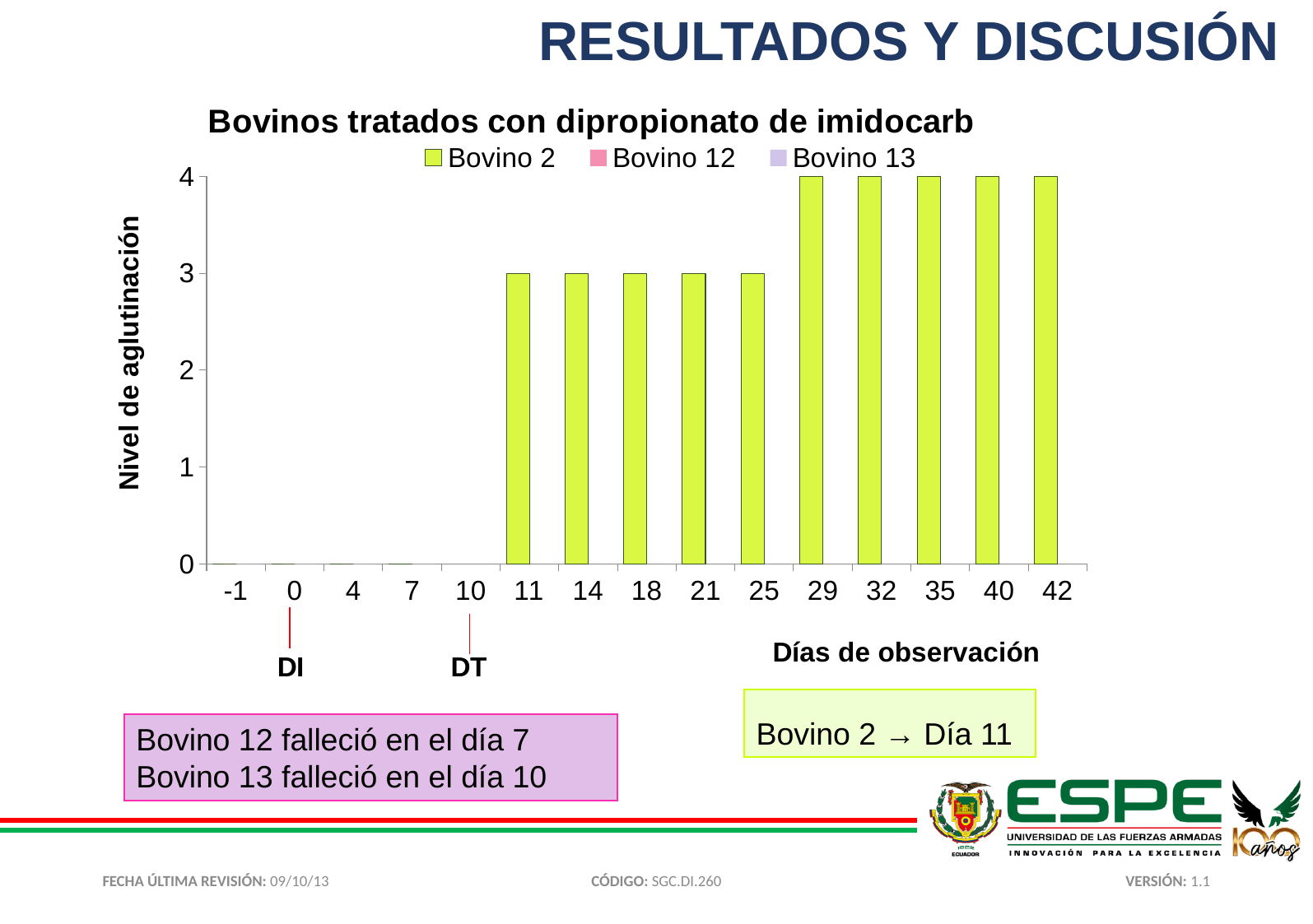
Is the value for Bovino 2 on day 32 greater or less than 3? greater What is the difference between the Bovino 2 value on day 29 and on day 25? 1 What is the title of the chart? Bovinos tratados con dipropionato de imidocarb Which is larger for Bovino 2: the value on day 14 or the value on day 35? day 35 What is the label of the y axis of the chart? Nivel de aglutinación What type of chart is shown on the slide? bar chart What is the agglutination level for Bovino 2 on day 42? 4 What is the agglutination level for Bovino 2 on day 11? 3 How many series does the chart legend list? 3 How many day categories are shown on the x axis of the chart? 15 What is the agglutination level for Bovino 2 on day 25? 3 Do the Bovino 2 values rise or fall from day 11 to day 42? rise